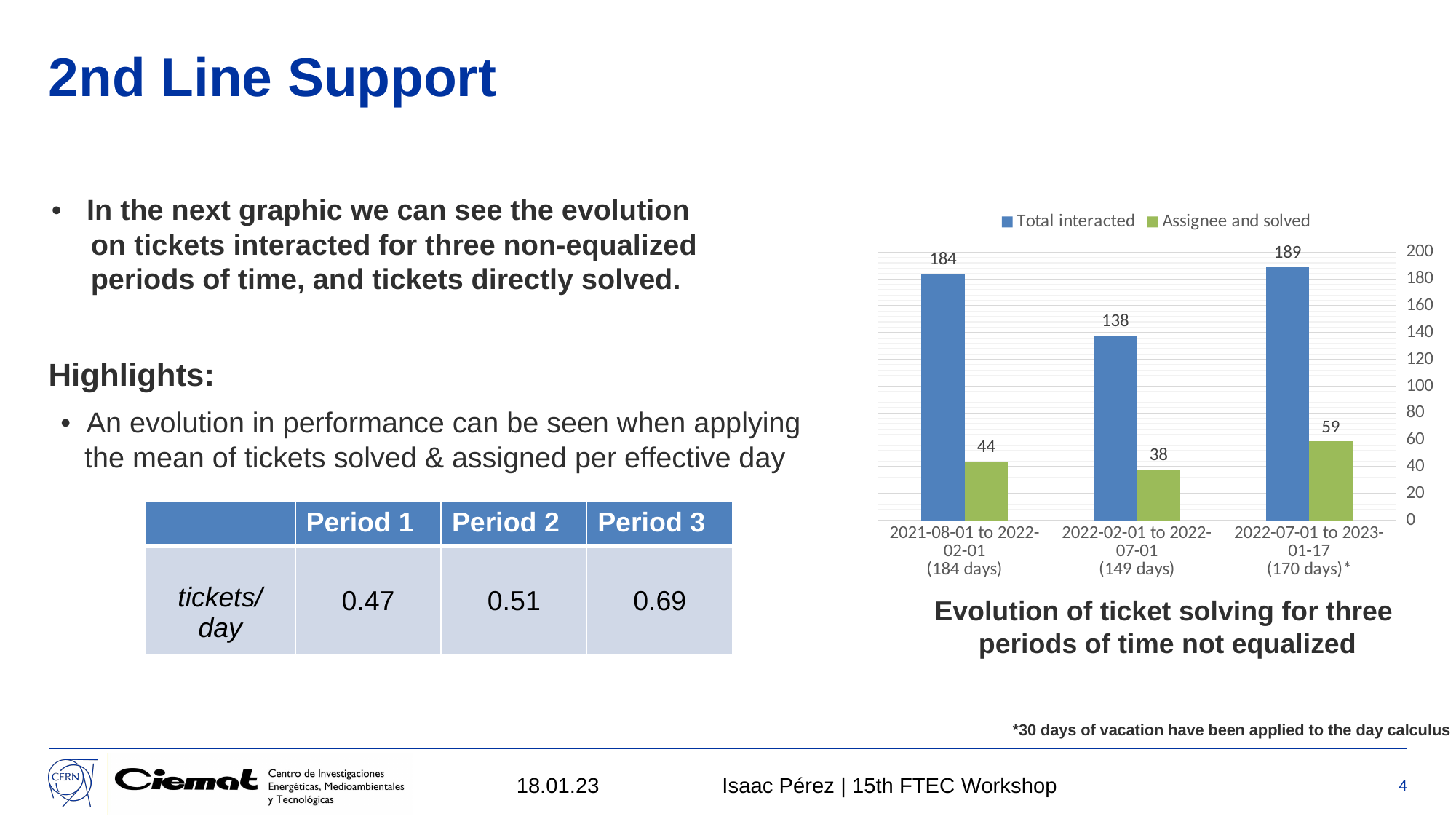
What kind of chart is shown on the slide? Bar chart What is the value of Assignee and solved for the period 2022-02-01 to 2022-07-01? 38 Which period has the lowest Assignee and solved value? 2022-02-01 to 2022-07-01 Which period has the highest Total interacted value? 2022-07-01 to 2023-01-17 What is the title of the chart? Evolution of ticket solving for three periods of time not equalized What is the value of Assignee and solved for the period 2022-07-01 to 2023-01-17? 59 What is the difference in Total interacted between the period 2022-07-01 to 2023-01-17 and the period 2021-08-01 to 2022-02-01? 5 How many periods are shown on the x axis of the chart? 3 What is the difference between Total interacted and Assignee and solved for the period 2022-02-01 to 2022-07-01? 100 How many series does the chart legend list? 2 What is the value of Total interacted for the period 2021-08-01 to 2022-02-01? 184 Which is larger: Assignee and solved for 2021-08-01 to 2022-02-01 or for 2022-07-01 to 2023-01-17? 2022-07-01 to 2023-01-17